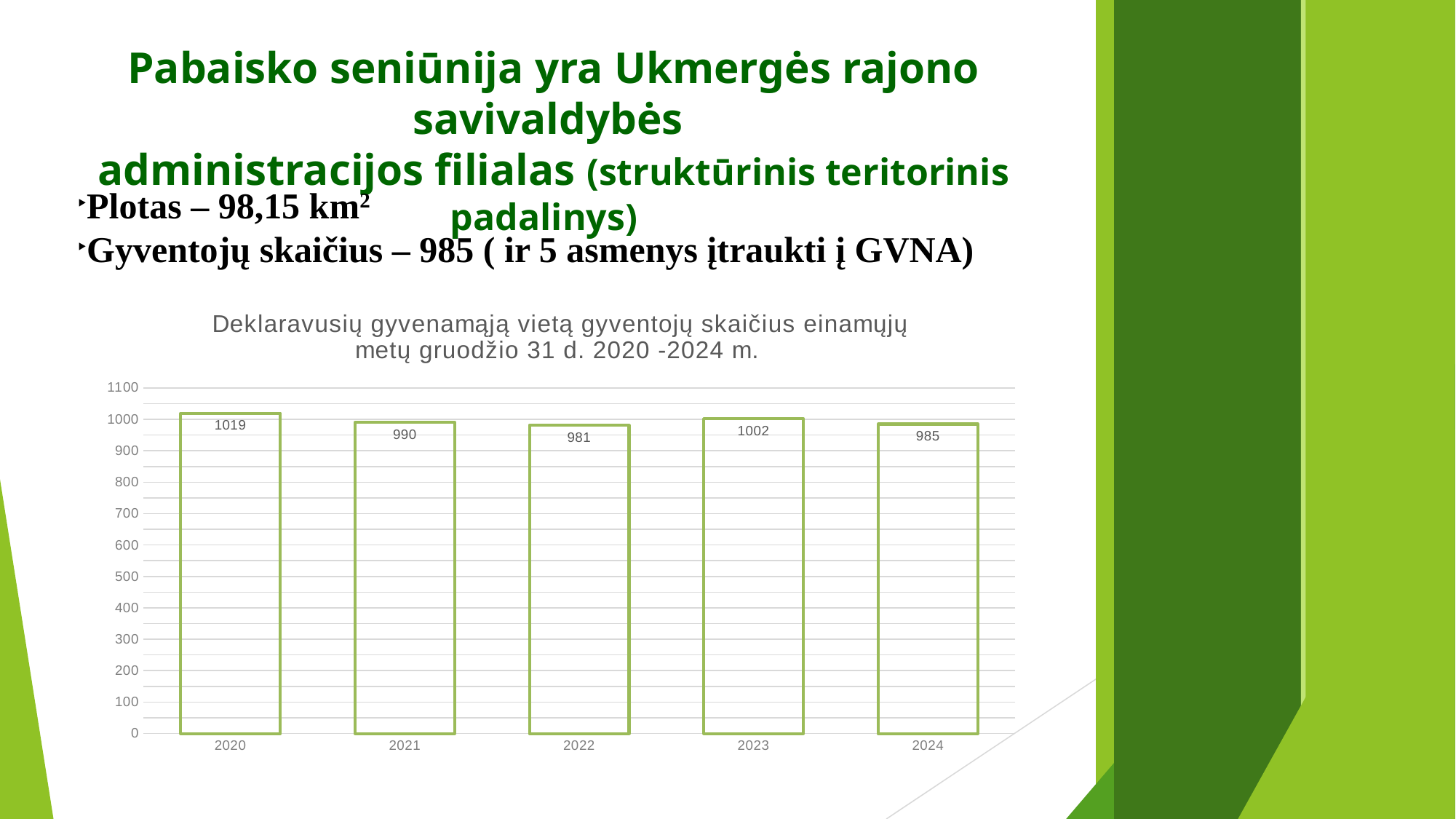
Is the value for 2022 greater or less than 1000? less Which year has the highest value? 2020 What is the value for 2024? 985 How many years are shown on the x axis? 5 Which is larger, the value for 2021 or the value for 2023? 2023 What is the title of the chart? Deklaravusių gyvenamąją vietą gyventojų skaičius einamųjų metų gruodžio 31 d. 2020 -2024 m. What kind of chart is shown on the slide? bar chart What is the value for 2023? 1002 What is the difference between the values for 2020 and 2022? 38 What is the difference between the values for 2023 and 2024? 17 Which year has the lowest value? 2022 What is the value for 2020? 1019